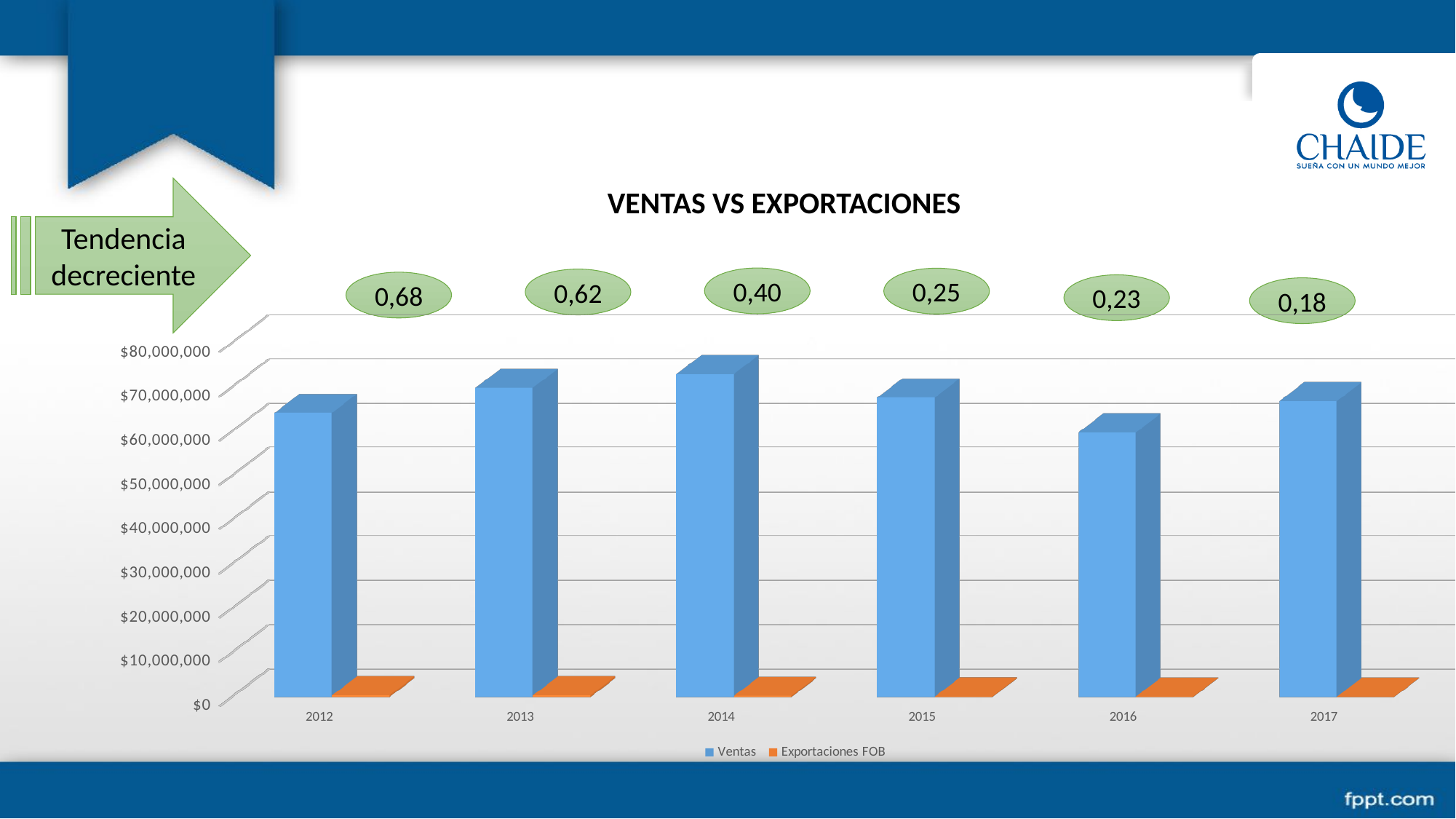
What is the title of the chart? VENTAS VS EXPORTACIONES How many series does the chart's legend list? 2 Which year has the larger Ventas value, 2012 or 2013? 2013 Is the Ventas value for 2014 greater or less than $70,000,000? greater What kind of chart is shown on the slide? bar chart Is the Exportaciones FOB value for 2015 greater or less than $10,000,000? less In which year is the Ventas bar the lowest? 2016 Is the Ventas value for 2016 greater or less than $70,000,000? less In which year is the Ventas bar the highest? 2014 How many years are shown on the x axis of the chart? 6 Which two series are listed in the chart's legend? Ventas and Exportaciones FOB Which year has the larger Ventas value, 2014 or 2016? 2014